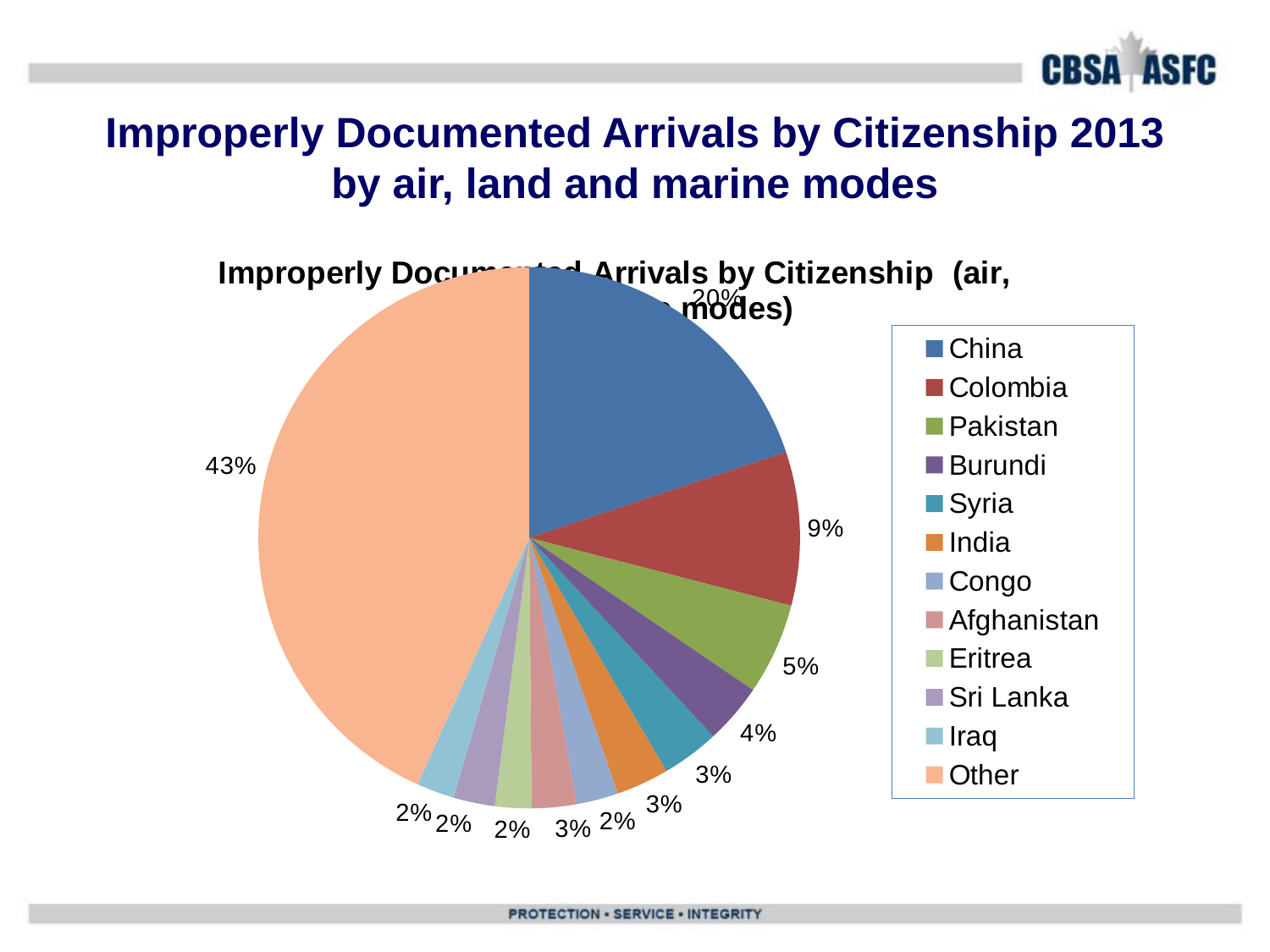
What share does Colombia account for? 9% What share is shown for Burundi? 4% By how many percentage points does the Other slice exceed the China slice? 23 percentage points What percentage of the pie is labelled for Other? 43% Which is larger, the share for China or the share for Colombia? China How many categories are listed in the legend? 12 Which category has the largest slice of the pie? Other What type of chart is shown on the slide? Pie chart By how many percentage points does China's share exceed Colombia's? 11 percentage points Which category is the last entry in the legend? Other What percentage is shown for Pakistan? 5% What share of improperly documented arrivals is attributed to China? 20%